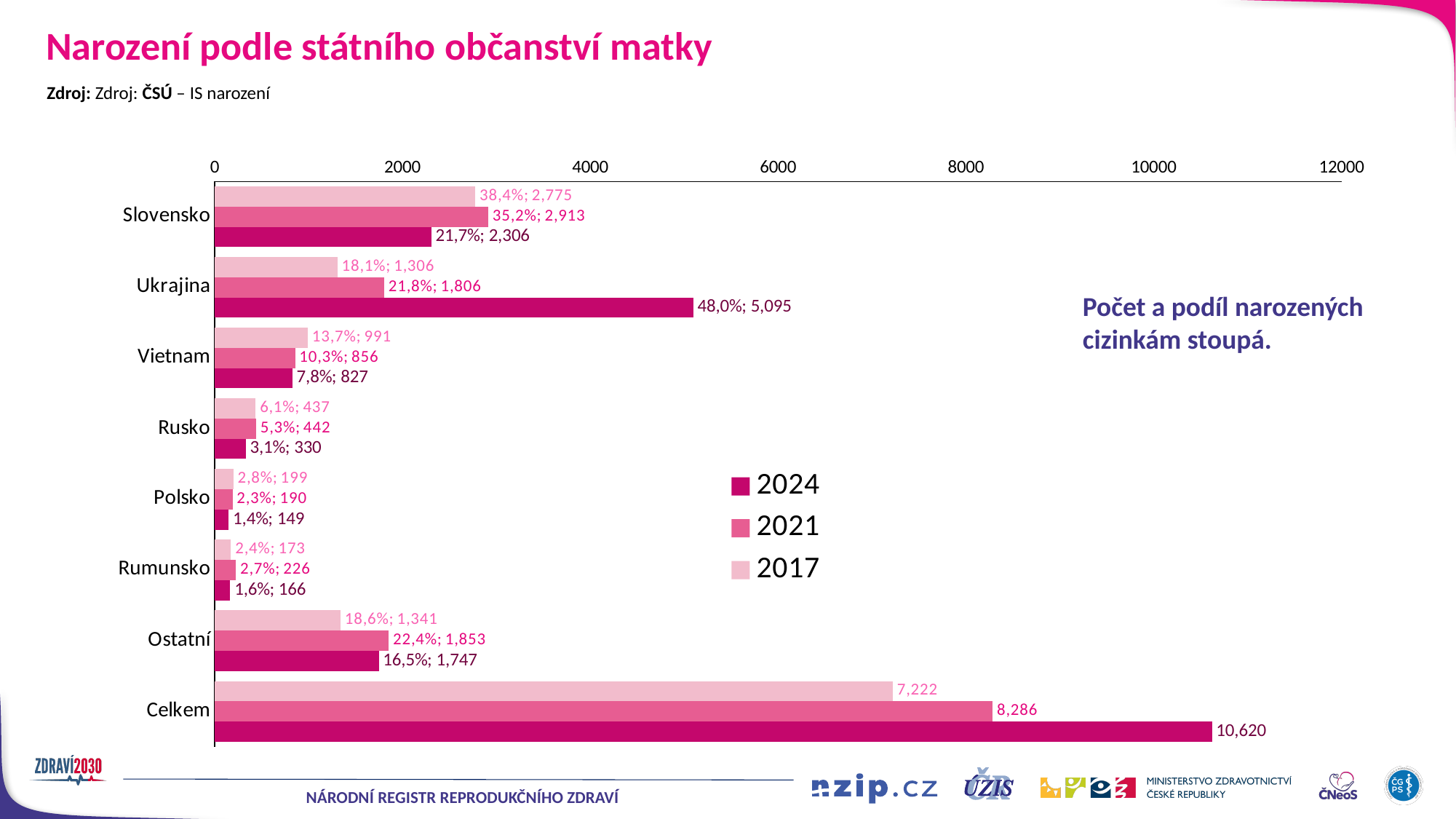
How many series does the legend list? 3 What kind of chart is shown on the slide? bar chart Which category (excluding Celkem) has the highest value in 2024? Ukrajina What is the difference in the number of births for Celkem between 2024 and 2017? 3,398 What is the value for Celkem in 2017? 7,222 What is the value for Ukrajina in 2024? 48,0%; 5,095 What is the title of the slide? Narození podle státního občanství matky Is the 2021 value for Celkem greater or less than 8000? greater Which is larger: the 2024 value for Slovensko or the 2024 value for Ukrajina? Ukrajina How many categories are shown on the y axis? 8 Which category has the lowest value in 2024? Polsko What is the value for Vietnam in 2021? 10,3%; 856